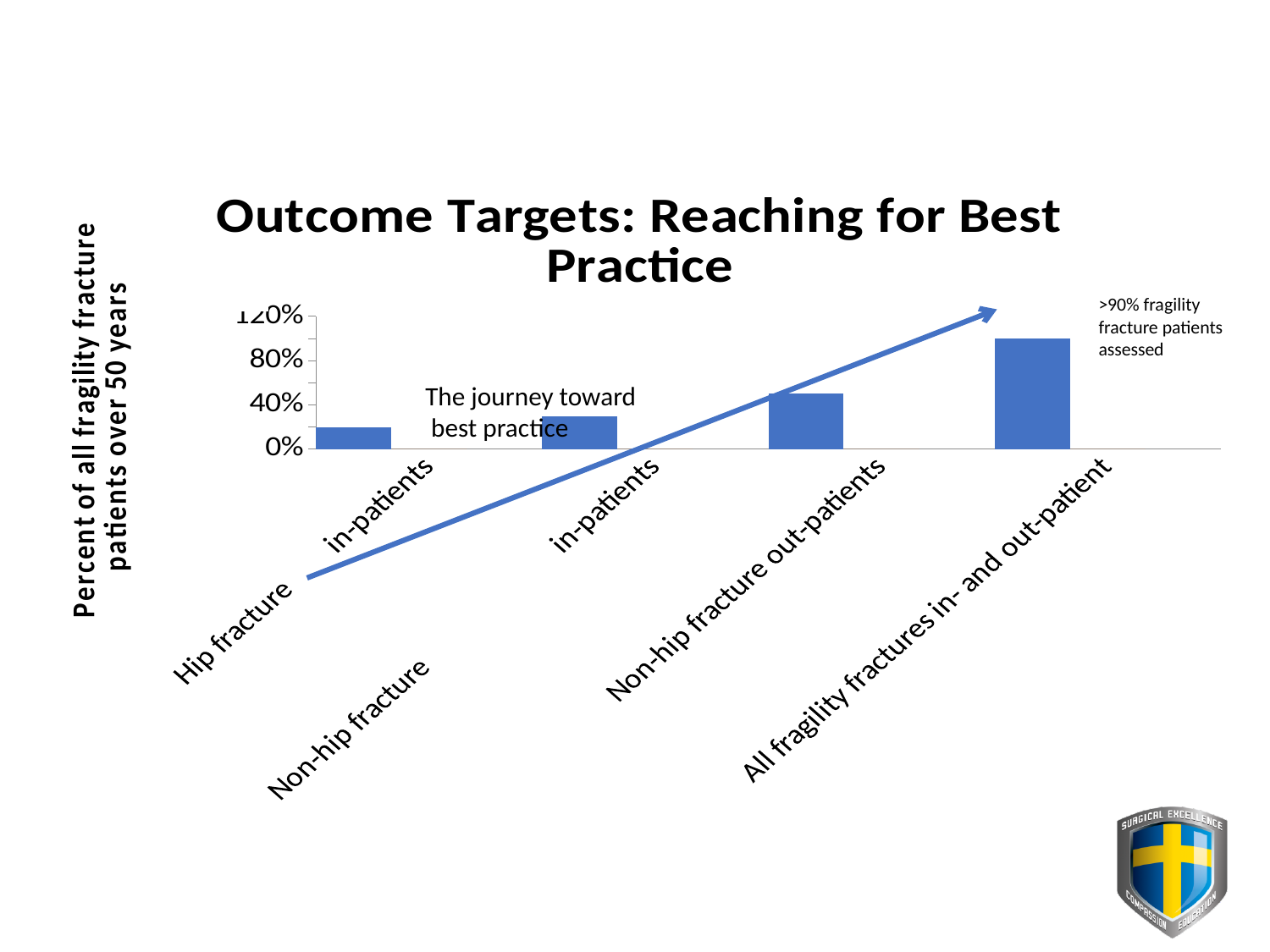
Is the value for Non-hip fracture in-patients greater or less than 40%? less Is the value for All fragility fractures in- and out-patient greater or less than 80%? greater How many categories are plotted on the x axis of the chart? 4 Which category has the lowest bar in the chart? Hip fracture in-patients Do the bar values rise or fall from left to right along the x axis? rise Which is larger, the value for Hip fracture in-patients or the value for All fragility fractures in- and out-patient? All fragility fractures in- and out-patient What is the label on the vertical axis of the chart? Percent of all fragility fracture patients over 50 years What kind of chart is shown on the slide? bar chart Is the value for Non-hip fracture out-patients greater or less than 80%? less What is the title of the chart? Outcome Targets: Reaching for Best Practice Which category has the highest bar in the chart? All fragility fractures in- and out-patient